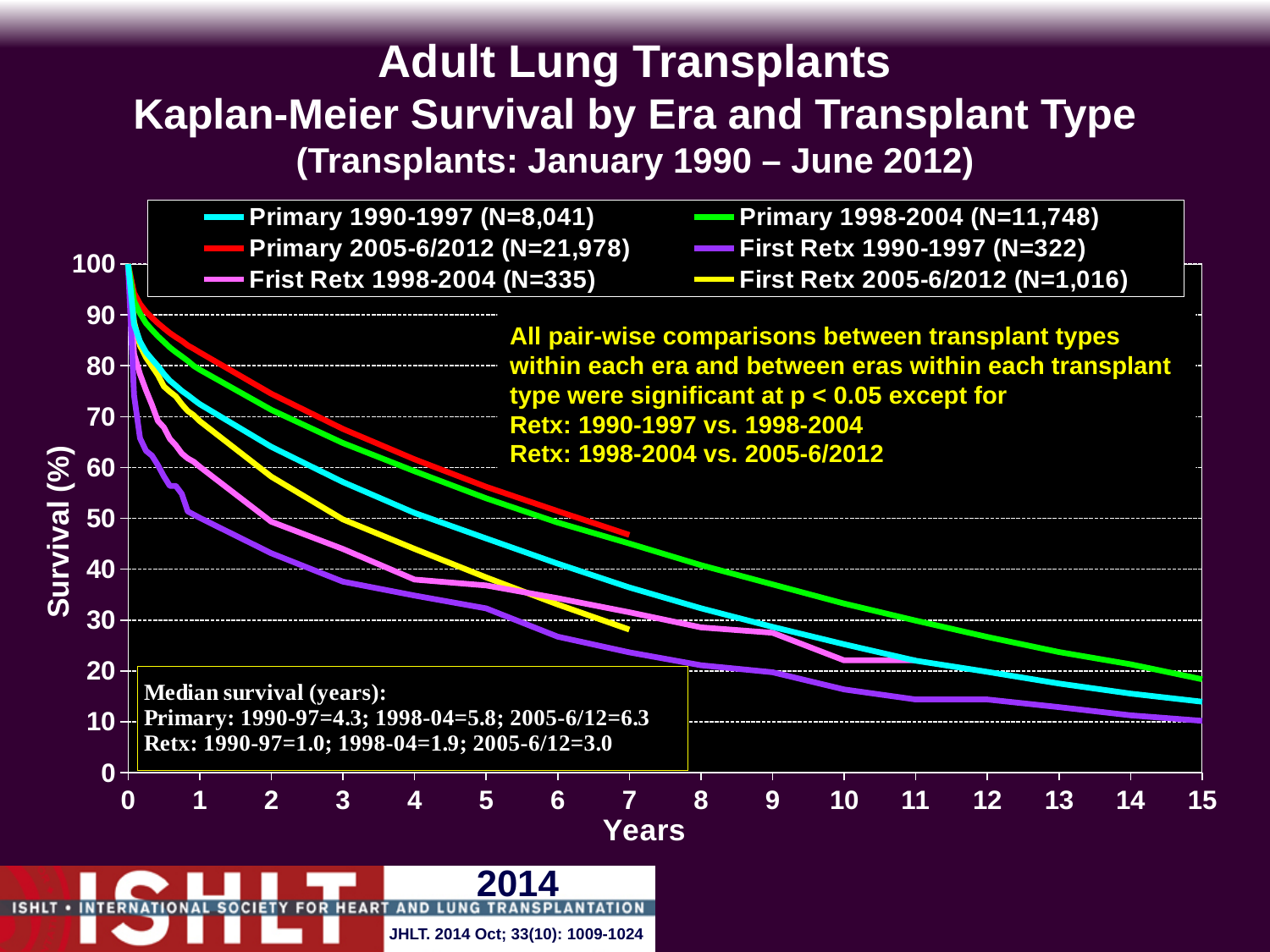
What is the median survival in years for Primary transplants in 1998-04, as printed in the text box? 5.8 At 5 years, which series has the highest survival? Primary 2005-6/2012 What is the title of the chart? Adult Lung Transplants Kaplan-Meier Survival by Era and Transplant Type What is the median survival in years for Retx transplants in 2005-6/12, as printed in the text box? 3.0 According to the legend, what is the N for the Primary 2005-6/2012 series? 21,978 Is the survival for Primary 2005-6/2012 at 5 years greater or less than 50? greater Is the survival for Primary 1998-2004 at 15 years greater or less than 20? less By how many years does the median survival for Primary 2005-6/12 exceed that for Primary 1990-97? 2.0 Do the survival curves rise or fall as years increase? fall What kind of chart is shown on the slide? line chart Is the survival for First Retx 1990-1997 at 5 years greater or less than 40? less How many series does the legend list? 6